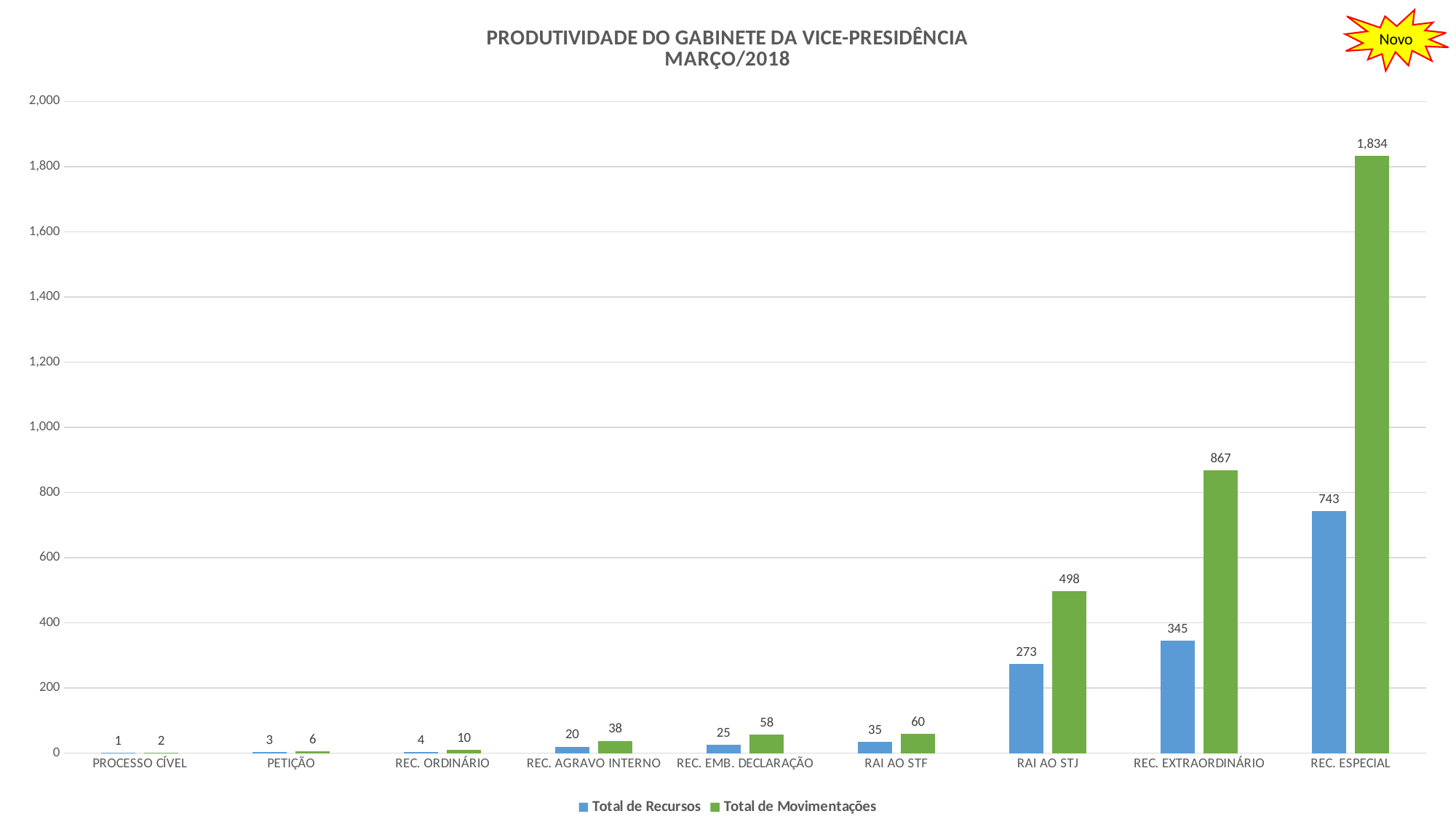
What colour are the Total de Movimentações bars? green Which is larger: Total de Movimentações for RAI AO STJ or Total de Recursos for REC. EXTRAORDINÁRIO? Total de Movimentações for RAI AO STJ Is the Total de Movimentações value for REC. EXTRAORDINÁRIO greater or less than 1,000? less What is the Total de Movimentações value for REC. ESPECIAL? 1,834 Which category has the lowest Total de Movimentações? PROCESSO CÍVEL What is the Total de Recursos value for RAI AO STJ? 273 Which category has the highest Total de Recursos? REC. ESPECIAL What is the difference between Total de Movimentações and Total de Recursos for REC. ESPECIAL? 1,091 What kind of chart is shown on the slide? bar chart How many categories are shown on the x axis? 9 How many series does the legend list? 2 What is the Total de Movimentações value for REC. EXTRAORDINÁRIO? 867